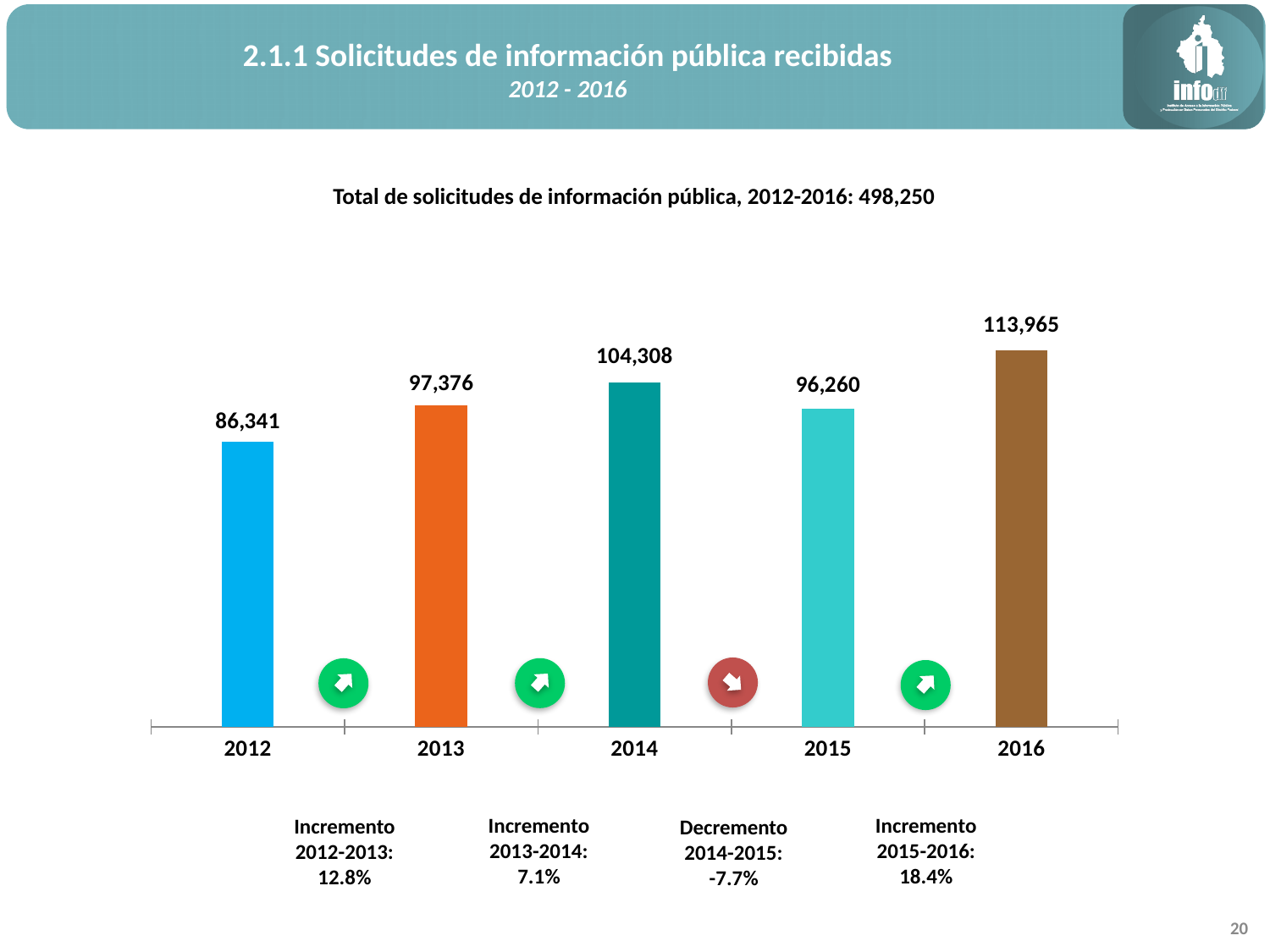
Which year has the highest value? 2016 What is the value for 2016? 113,965 What is the value for 2012? 86,341 What kind of chart is shown on the slide? bar chart How many years are shown on the x axis? 5 What is the difference between the values for 2016 and 2015? 17,705 Which is larger, the value for 2014 or the value for 2015? 2014 Between 2014 and 2015, does the value rise or fall? fall What percentage change is shown for 2015-2016? 18.4% Which year has the lowest value? 2012 What is the difference between the values for 2013 and 2012? 11,035 What is the value for 2014? 104,308